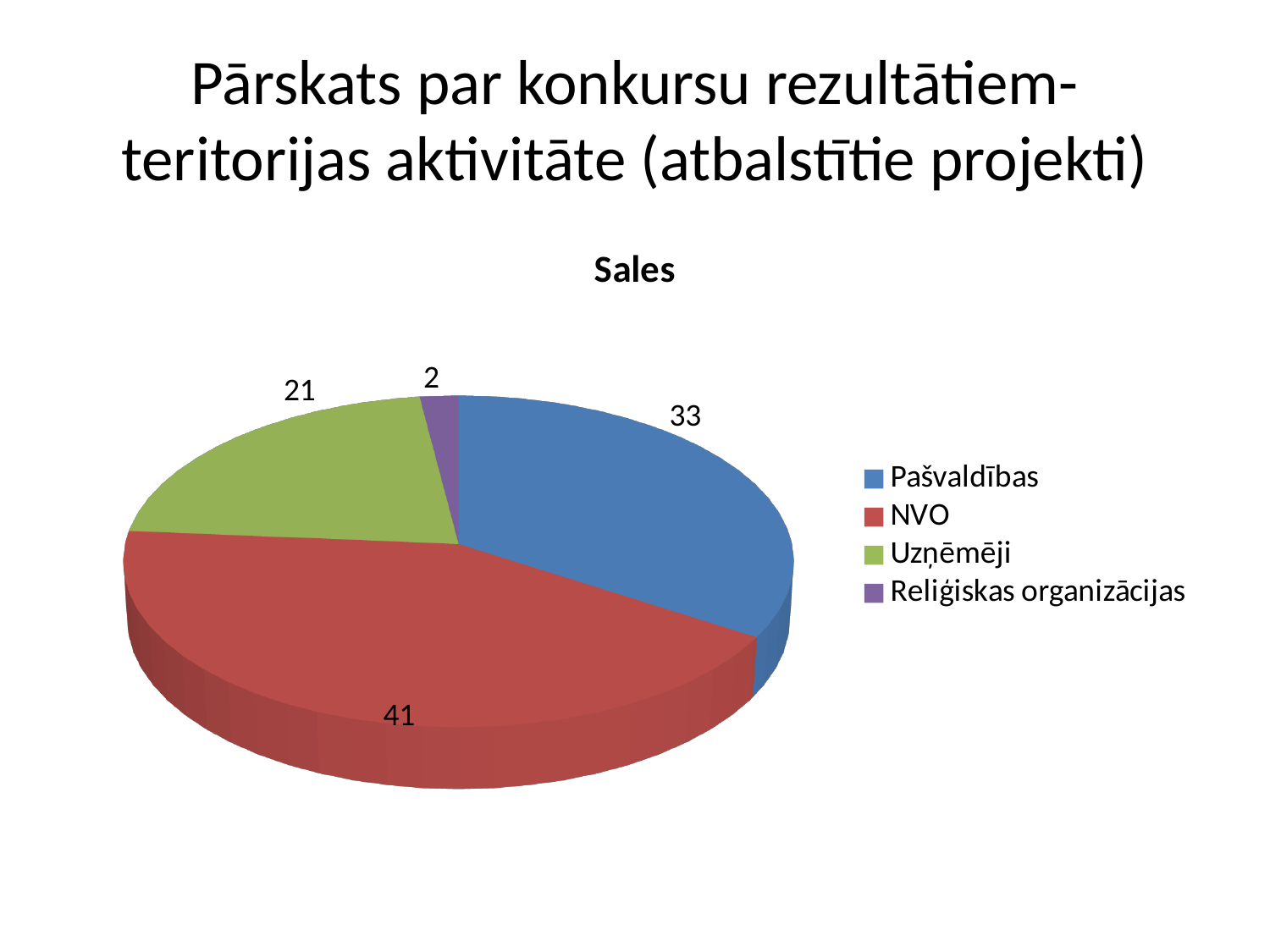
What is the title of the chart? Sales What is the value for Reliģiskas organizācijas? 2 Which category has the largest slice? NVO What is the value for NVO? 41 What is the value for Pašvaldības? 33 Which category has the smallest slice? Reliģiskas organizācijas What type of chart is shown on the slide? pie chart What is the difference between the values for NVO and Pašvaldības? 8 How many categories does the legend list? 4 What is the value for Uzņēmēji? 21 Which is larger, the value for Pašvaldības or the value for Uzņēmēji? Pašvaldības What is the total of all the slices in the pie? 97